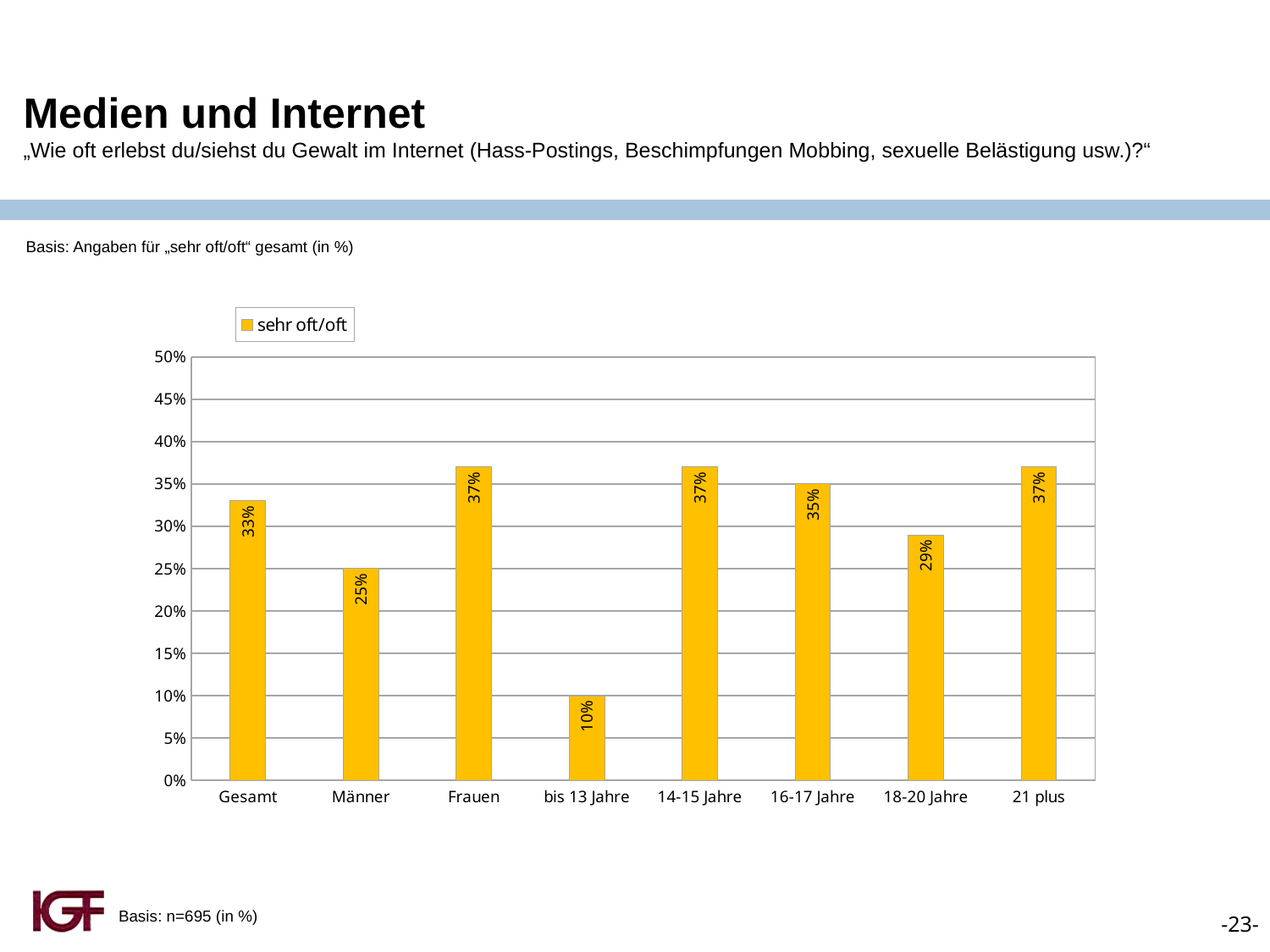
How many categories are shown on the x axis? 8 What is the value for 18-20 Jahre? 29% What is the value for Männer? 25% What is the difference between the values for Frauen and Männer? 12% How many series does the legend list? 1 Which is larger, the value for 16-17 Jahre or the value for 18-20 Jahre? 16-17 Jahre Which category has the lowest value? bis 13 Jahre What is the value for Gesamt? 33% What kind of chart is shown? bar chart Is the value for 14-15 Jahre greater or less than 30%? greater What is the value for bis 13 Jahre? 10% What is the legend entry for the series? sehr oft/oft